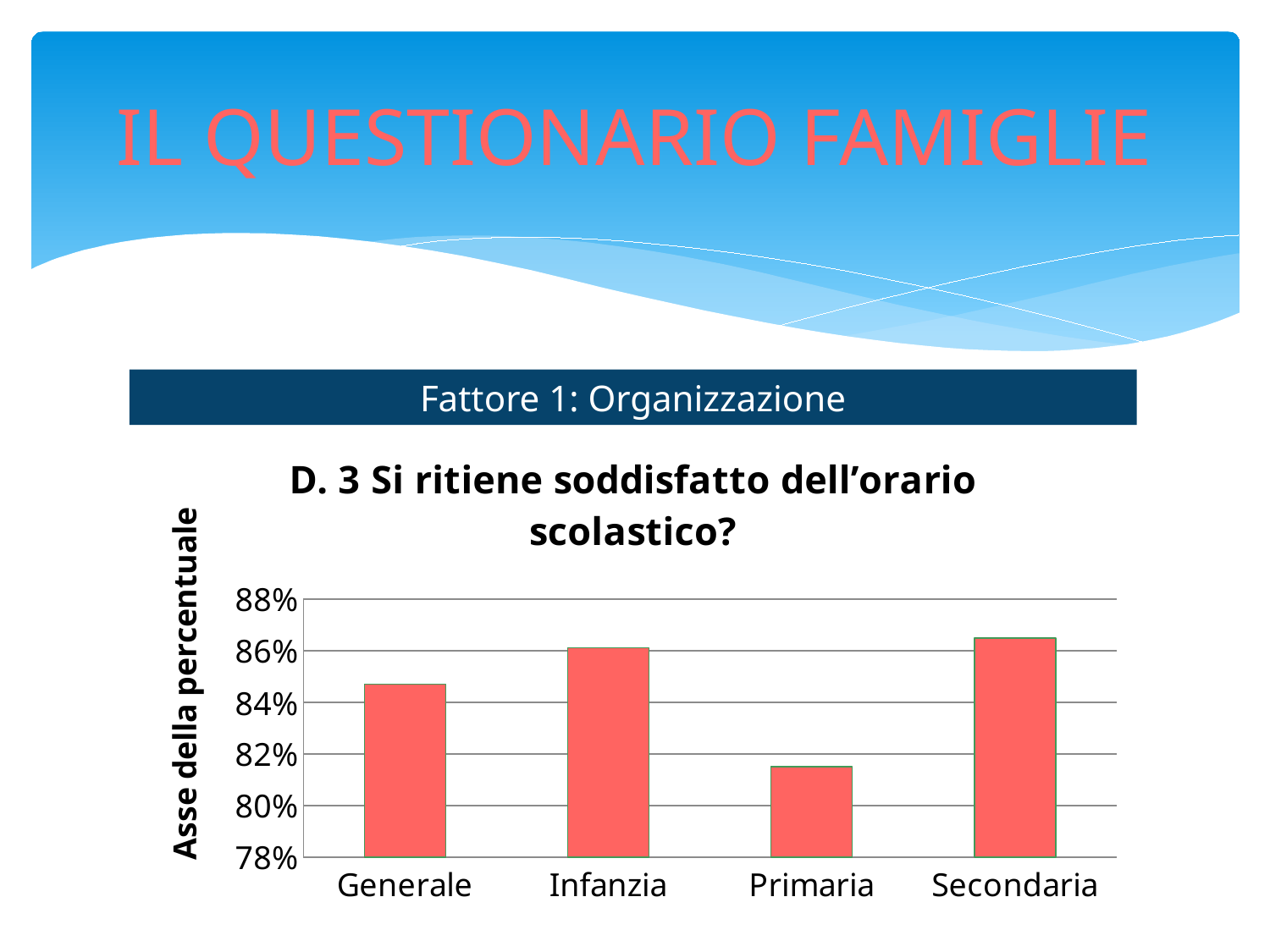
Which is larger, the value for Infanzia or the value for Primaria? Infanzia Is the value for Infanzia greater or less than 84%? greater What is the title of the chart? D. 3 Si ritiene soddisfatto dell'orario scolastico? Is the value for Primaria greater or less than 82%? less Is the value for Generale greater or less than 84%? greater What kind of chart is shown on the slide? bar chart Which category has the lowest value in the chart? Primaria Which is larger, the value for Generale or the value for Primaria? Generale What is the label of the vertical axis of the chart? Asse della percentuale How many categories are shown on the x axis of the chart? 4